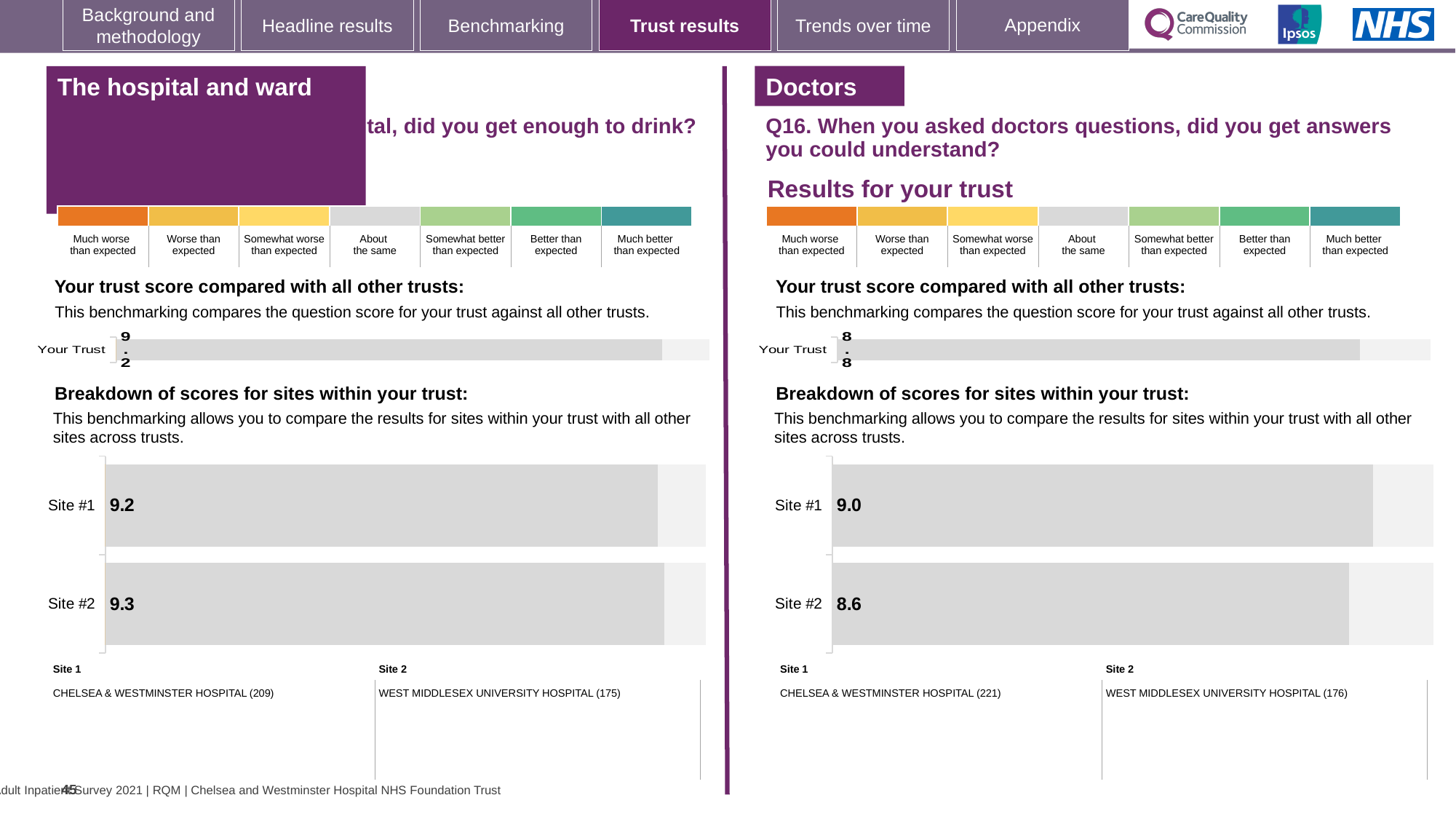
On the left-hand 'Breakdown of scores for sites within your trust' chart, what is the score for Site #1? 9.2 On the left-hand 'Your trust score compared with all other trusts' chart, what is the score for Your Trust? 9.2 On the right-hand (Doctors, Q16) site breakdown chart, what is the difference between the Site #1 and Site #2 scores? 0.4 On the right-hand (Doctors, Q16) 'Your trust score compared with all other trusts' chart, what is the score for Your Trust? 8.8 How many sites are shown on the right-hand (Doctors, Q16) site breakdown chart? 2 On the left-hand site breakdown chart, what is the difference between the Site #2 and Site #1 scores? 0.1 On the right-hand (Doctors, Q16) site breakdown chart, which site has the higher score? Site #1 On the right-hand (Doctors, Q16) site breakdown chart, which hospital is listed as Site 2? West Middlesex University Hospital (176) On the right-hand (Doctors, Q16) 'Breakdown of scores for sites within your trust' chart, what is the score for Site #2? 8.6 On the right-hand (Doctors, Q16) 'Breakdown of scores for sites within your trust' chart, what is the score for Site #1? 9.0 On the left-hand 'Breakdown of scores for sites within your trust' chart, what is the score for Site #2? 9.3 What type of chart is used for the site breakdown on the left-hand side of the slide? Bar chart